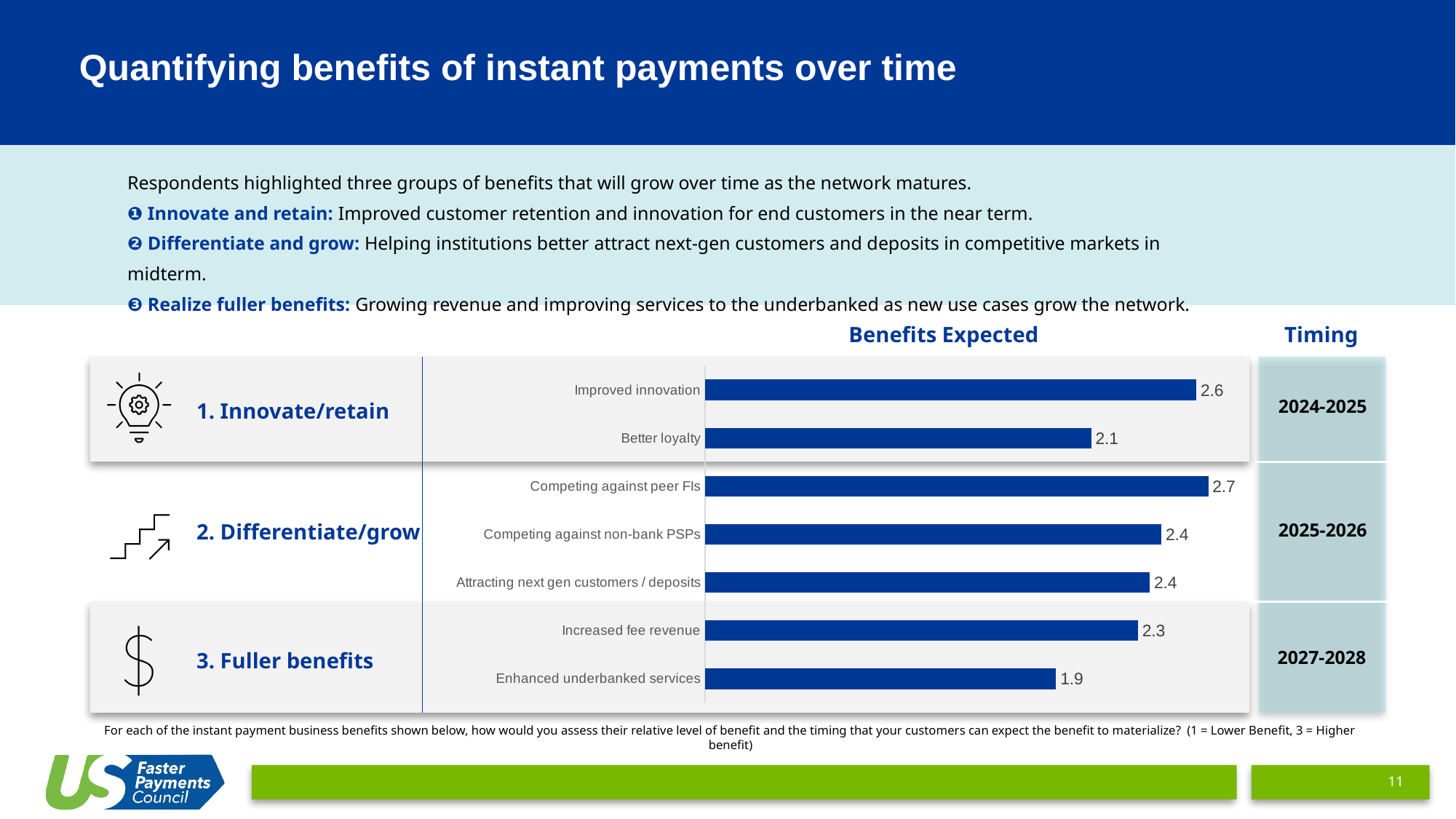
What is the value for Better loyalty? 2.1 What is the difference between the values for Competing against peer FIs and Enhanced underbanked services? 0.8 What is the value for Increased fee revenue? 2.3 How many categories are shown in the chart? 7 Which is larger, the value for Improved innovation or the value for Better loyalty? Improved innovation Which category has the highest value? Competing against peer FIs What is the value for Competing against peer FIs? 2.7 What is the timing shown for the Fuller benefits group? 2027-2028 What kind of chart is shown on the slide? Bar chart Which category has the lowest value? Enhanced underbanked services What is the value for Improved innovation? 2.6 What is the value for Enhanced underbanked services? 1.9